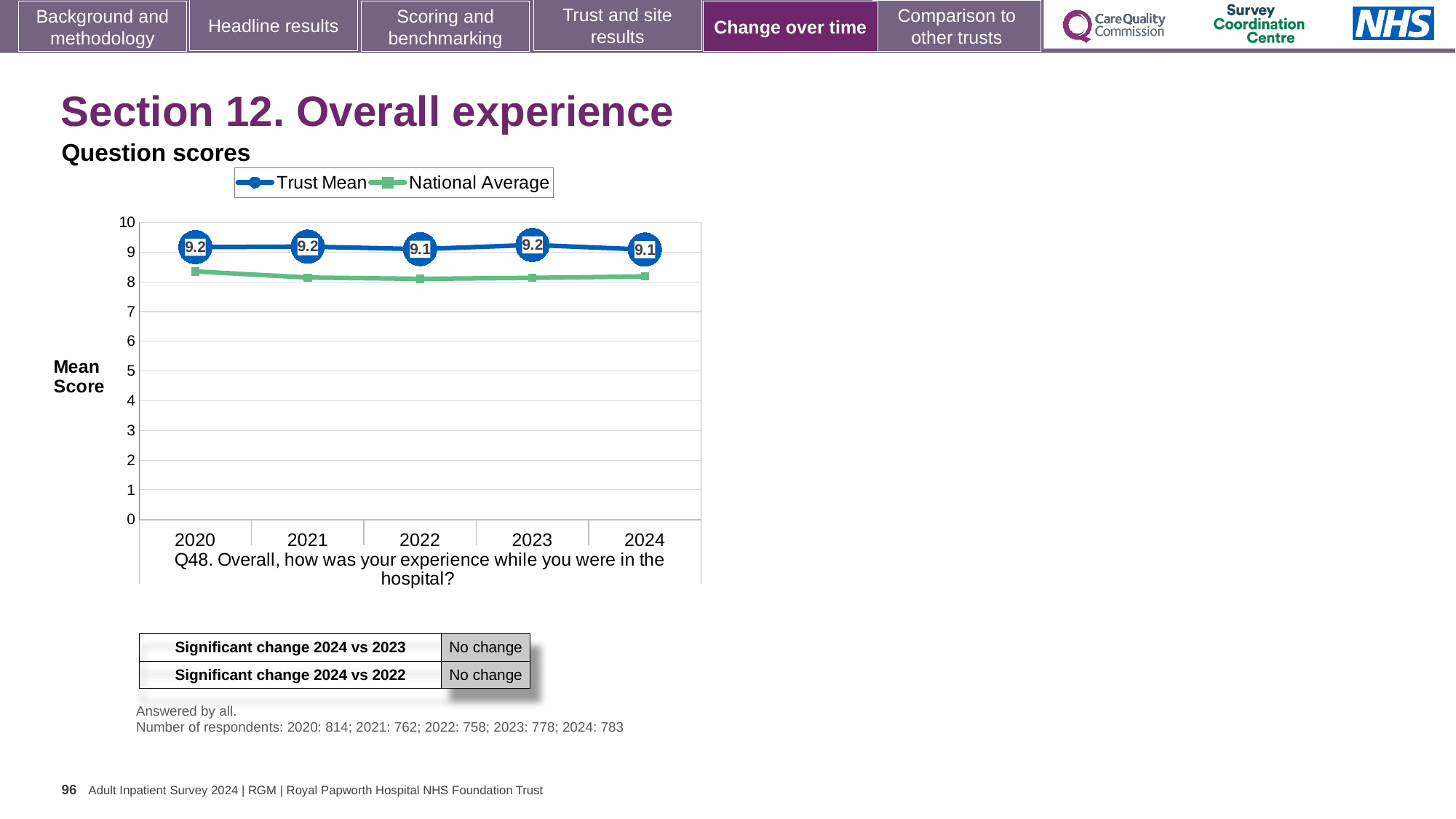
Is the National Average value for 2022 greater or less than 9? less What kind of chart is shown on the slide? line chart What is the Trust Mean score for 2020? 9.2 Is the National Average value for 2020 greater or less than 8? greater What is the label on the y axis of the chart? Mean Score What is the Trust Mean score for 2022? 9.1 How many series does the legend list? 2 What is the Trust Mean score for 2024? 9.1 What is the difference between the Trust Mean scores for 2023 and 2024? 0.1 Is the Trust Mean for 2021 greater or less than the National Average for 2021? greater What is the Trust Mean score for 2023? 9.2 How many years are plotted on the x axis? 5